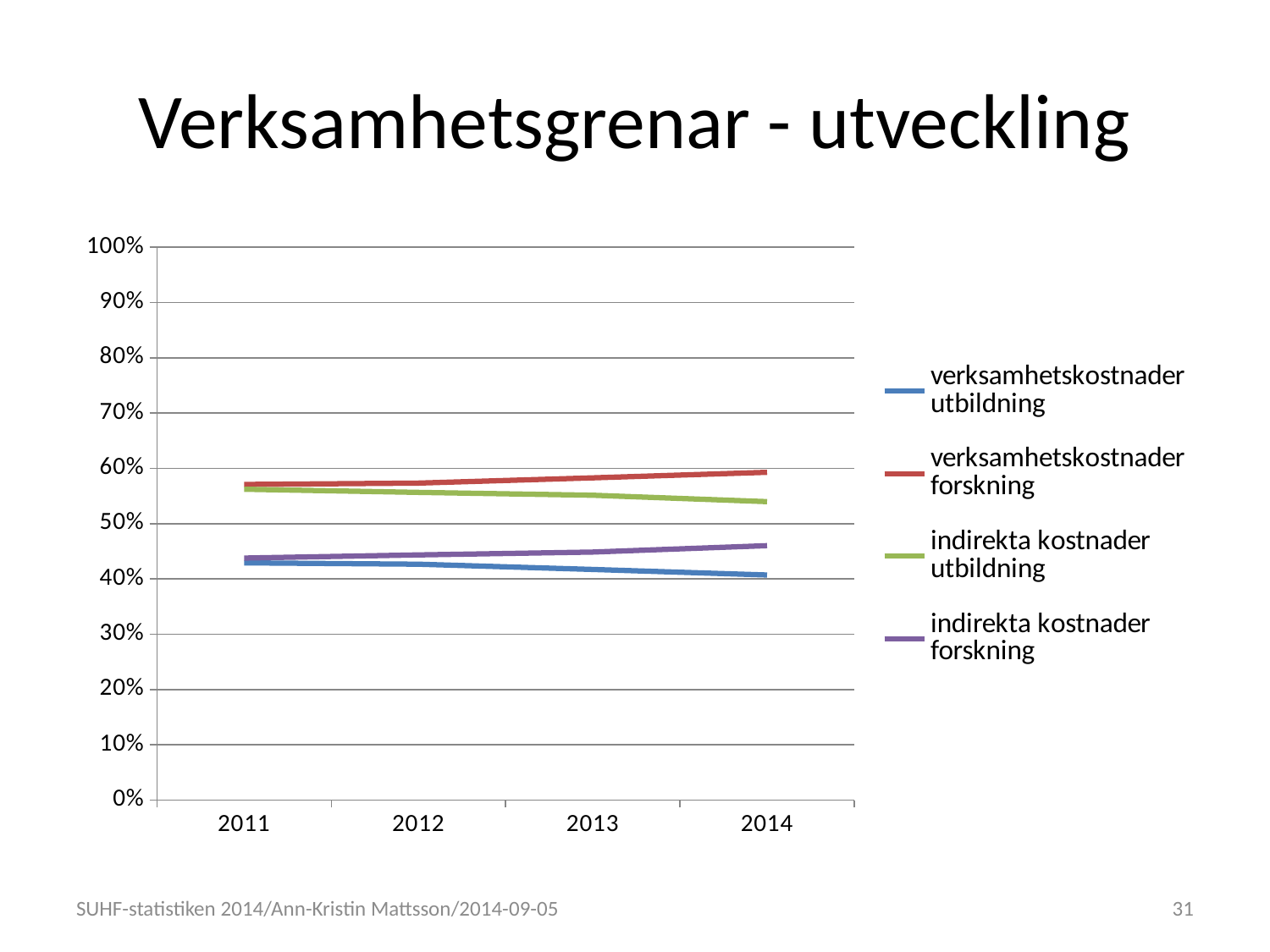
Is the value for verksamhetskostnader utbildning in 2014 greater or less than 50%? less Does the value for indirekta kostnader utbildning rise or fall from 2011 to 2014? fall What kind of chart is shown on the slide? line chart How many series does the legend list? 4 Does the value for verksamhetskostnader utbildning rise or fall from 2011 to 2014? fall Does the value for verksamhetskostnader forskning rise or fall from 2011 to 2014? rise Which series has the highest value in 2014? verksamhetskostnader forskning Which series has the lowest value in 2014? verksamhetskostnader utbildning Is the value for indirekta kostnader forskning in 2011 greater or less than 50%? less Is the value for verksamhetskostnader forskning in 2014 greater or less than 50%? greater In 2014, which is larger: indirekta kostnader forskning or verksamhetskostnader utbildning? indirekta kostnader forskning How many years are shown on the x axis? 4